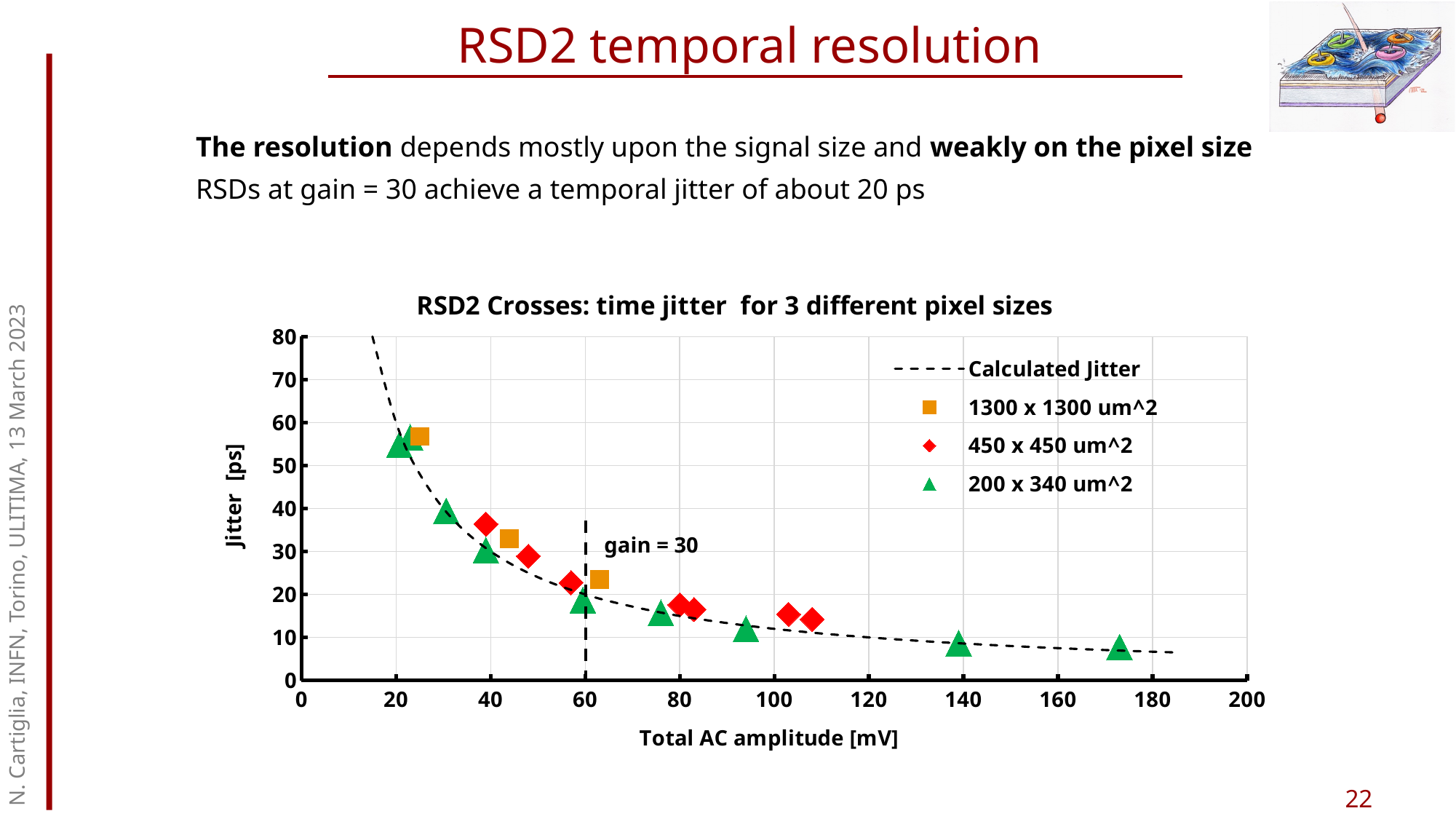
As Total AC amplitude increases, does the jitter rise or fall? Fall Is the jitter of the 450 x 450 um^2 point near 108 mV greater or less than 20 ps? less Is the jitter of the 1300 x 1300 um^2 point near 25 mV greater or less than 50 ps? greater How many orange square data points (1300 x 1300 um^2) are plotted? 3 What is the title of the chart? RSD2 Crosses: time jitter for 3 different pixel sizes Which series contains the point with the lowest jitter on the chart? 200 x 340 um^2 At what Total AC amplitude is the dashed vertical 'gain = 30' line drawn? 60 How many entries does the chart legend list? 4 What kind of chart is shown on the slide? Scatter chart Is the jitter of the 1300 x 1300 um^2 point near 63 mV greater or less than 30 ps? less Which legend entry is drawn as a dashed line? Calculated Jitter